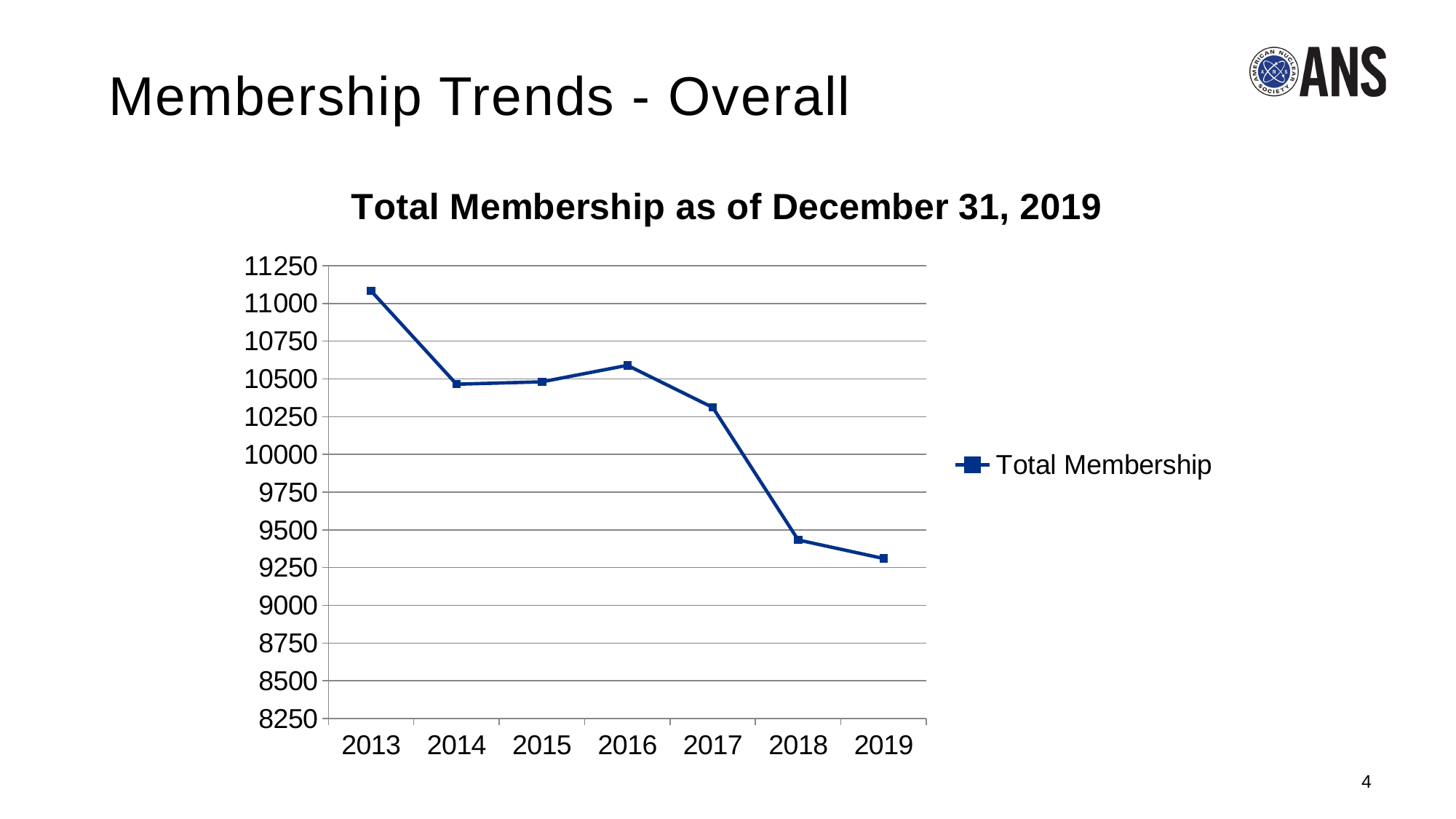
Is the total membership for 2016 greater or less than 10500? greater What is the name of the series shown in the legend? Total Membership How many years are plotted on the x axis? 7 Which year has the highest total membership? 2013 Is the total membership for 2013 greater or less than 11000? greater How many series does the legend list? 1 Which year has the lowest total membership? 2019 What is the title of the chart? Total Membership as of December 31, 2019 Overall, does total membership rise or fall from 2013 to 2019? fall Is the total membership for 2018 greater or less than 9500? less Which year has the larger total membership, 2016 or 2017? 2016 What kind of chart is shown on the slide? line chart